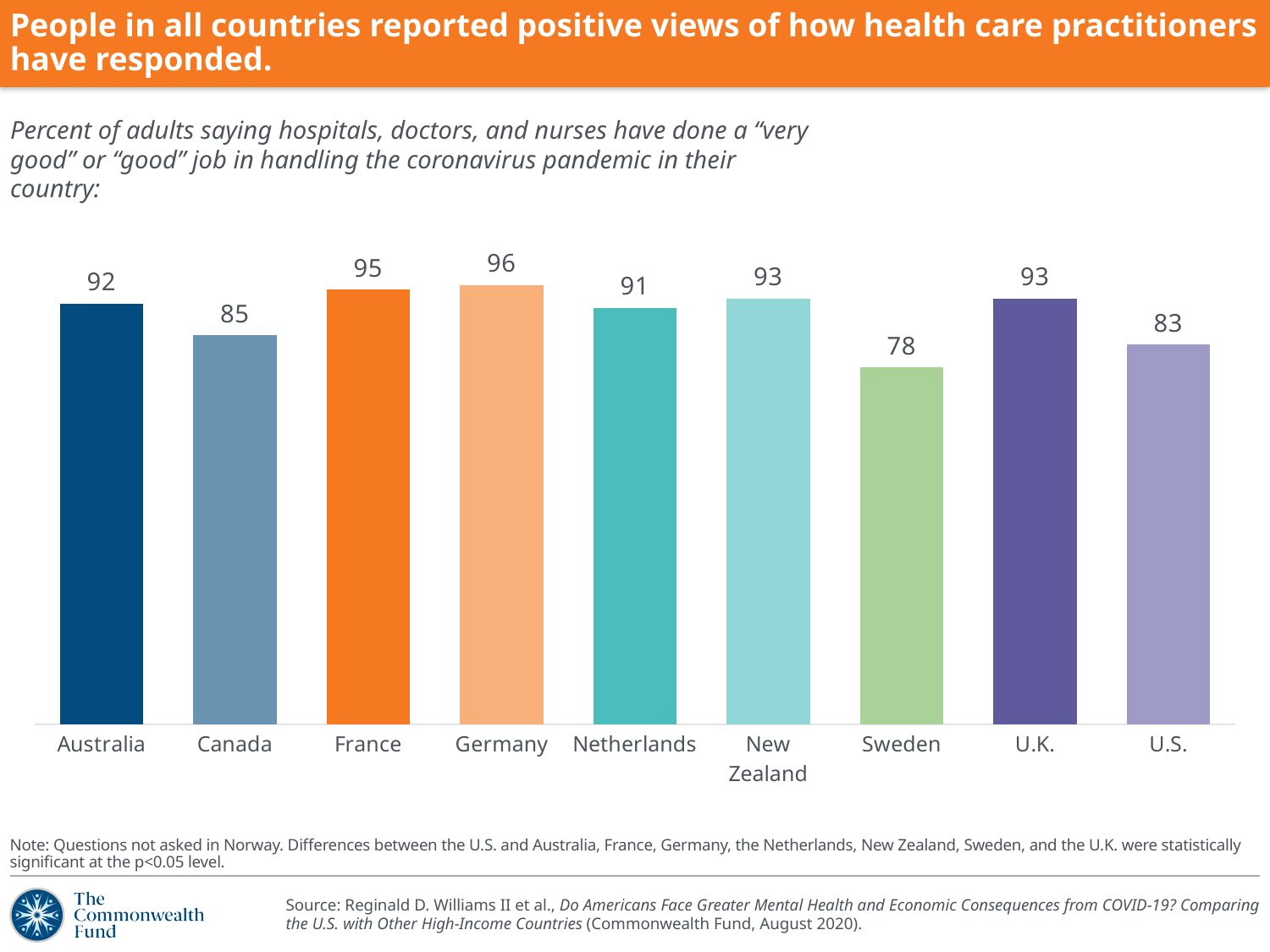
Which country has the highest value in the chart? Germany Which country has the lowest value in the chart? Sweden Which has a higher value, Canada or the U.K.? U.K. What type of chart is shown on the slide? Bar chart What is the value shown for the U.S.? 83 What percent of adults in Australia said hospitals, doctors, and nurses have done a very good or good job handling the pandemic? 92 Which has a higher value, France or the Netherlands? France What is the value shown for Sweden? 78 Which two countries share the same value of 93? New Zealand and U.K. How many countries are shown in the chart? 9 What is the difference between the values for Germany and the U.S.? 13 What is the difference between the values for Australia and Canada? 7